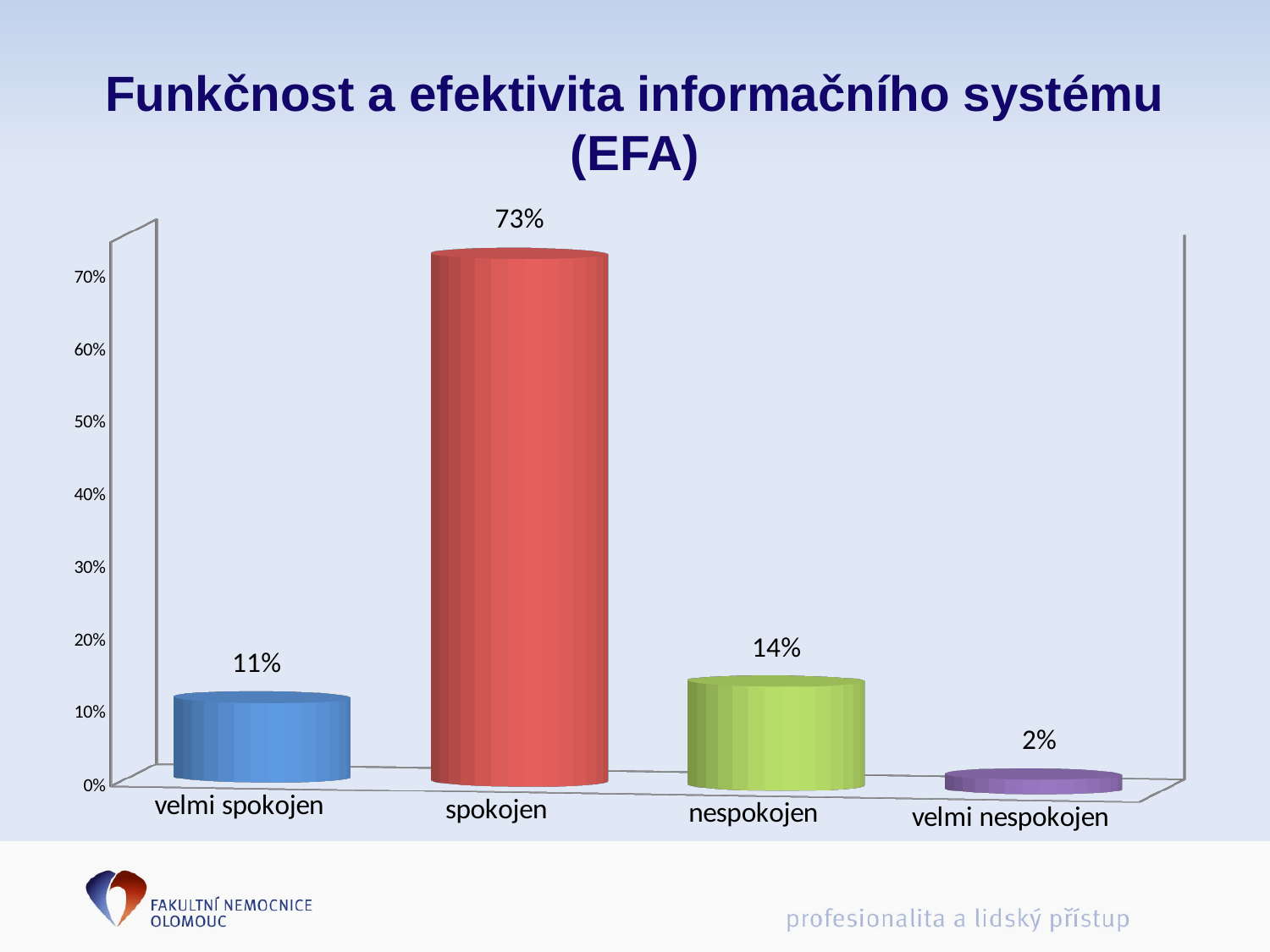
Which category has the highest value? spokojen What is the value for spokojen? 73% What is the value for nespokojen? 14% What kind of chart is shown on the slide? bar chart What is the difference between the values for spokojen and nespokojen? 59% Which category has the lowest value? velmi nespokojen What is the difference between the values for nespokojen and velmi spokojen? 3% What is the value for velmi nespokojen? 2% Which is larger, the value for velmi spokojen or the value for nespokojen? nespokojen What is the value for velmi spokojen? 11% Is the value for spokojen greater or less than 50%? greater How many categories are shown on the x axis? 4